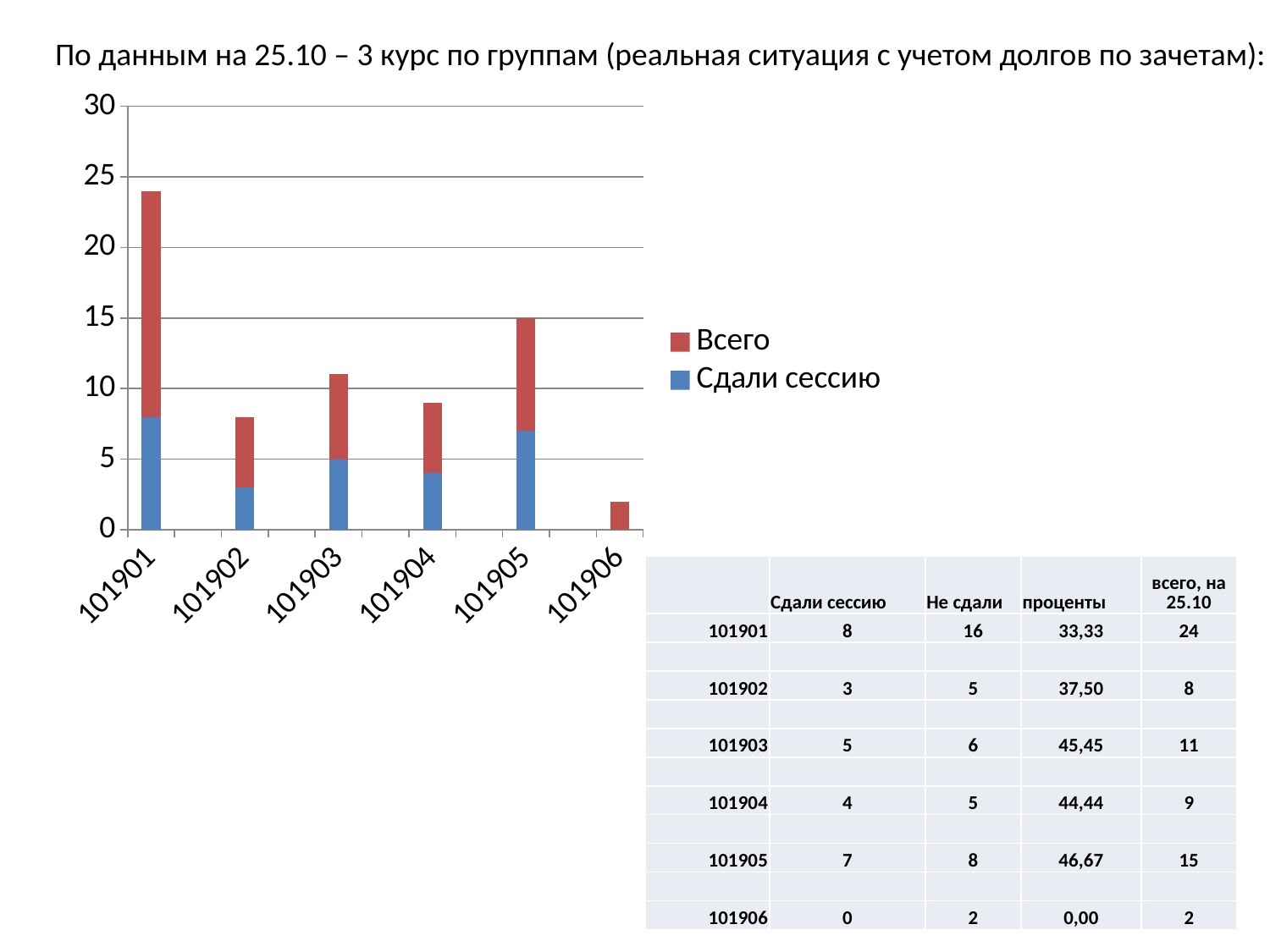
What is the value of 'Сдали сессию' for group 101903? 5 Which group has the taller bar, 101903 or 101904? 101903 Is the total bar height for group 101901 greater or less than 20? greater How many groups are shown along the x axis of the chart? 6 What are the two entries in the chart legend? Всего, Сдали сессию What is the total bar height for group 101905? 15 What kind of chart is shown on the slide? bar chart Which group has the tallest bar in the chart? 101901 How many series does the chart legend list? 2 Is the total bar height for group 101902 greater or less than 10? less Which group has the shortest bar in the chart? 101906 What is the value of 'Сдали сессию' for group 101906? 0